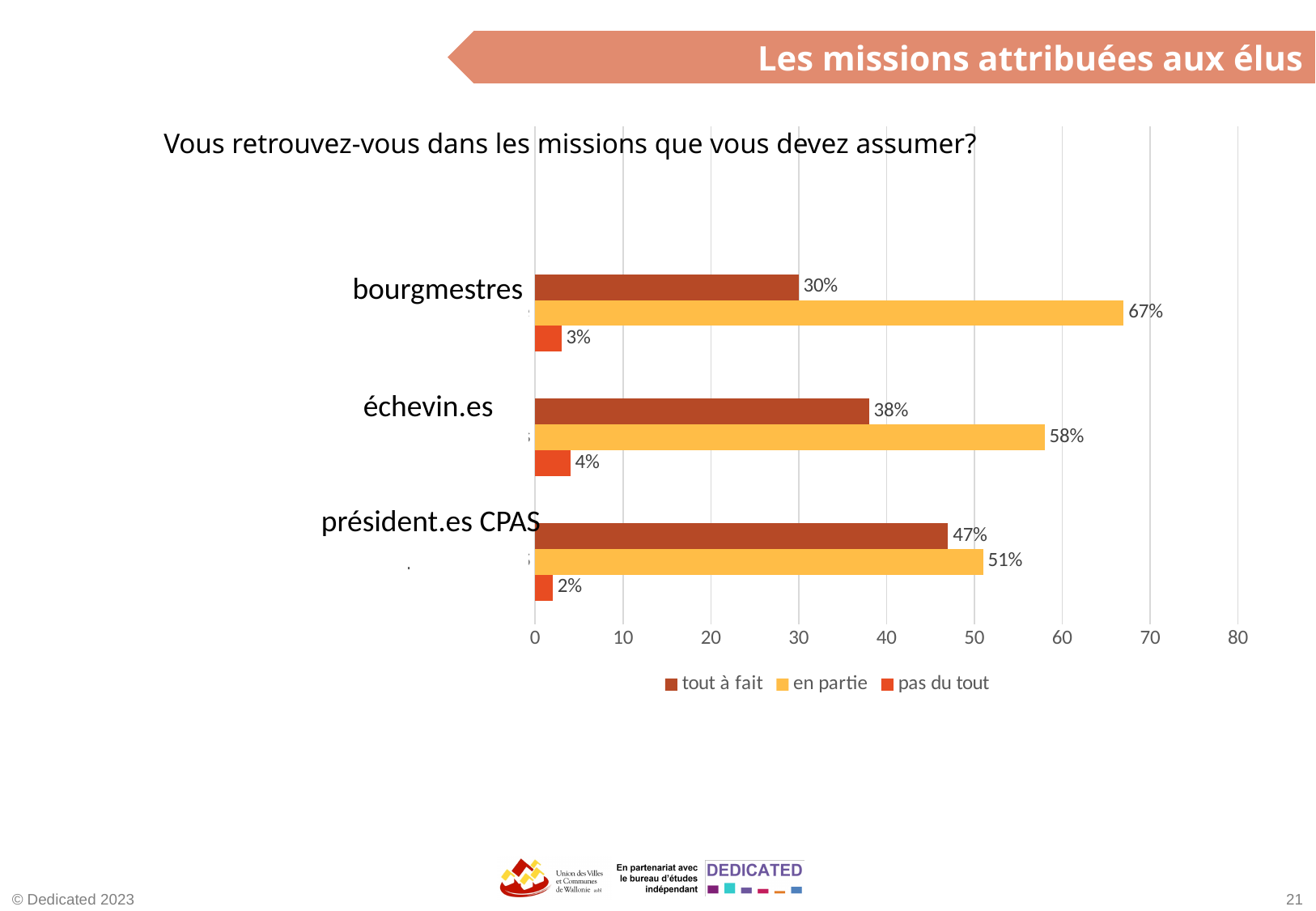
What question is the chart about, as written above it? Vous retrouvez-vous dans les missions que vous devez assumer? What is the value for 'pas du tout' for échevin.es? 4% What is the difference between the 'en partie' and 'tout à fait' values for échevin.es? 20% Which is larger for bourgmestres: 'tout à fait' or 'en partie'? en partie How many categories are shown on the chart? 3 What is the value for 'en partie' for bourgmestres? 67% Is the 'en partie' value for bourgmestres greater or less than 60? greater How many series does the legend list? 3 Which category has the highest 'tout à fait' value? président.es CPAS What is the value for 'tout à fait' for président.es CPAS? 47% What kind of chart is shown on the slide? bar chart Which category has the lowest 'pas du tout' value? président.es CPAS